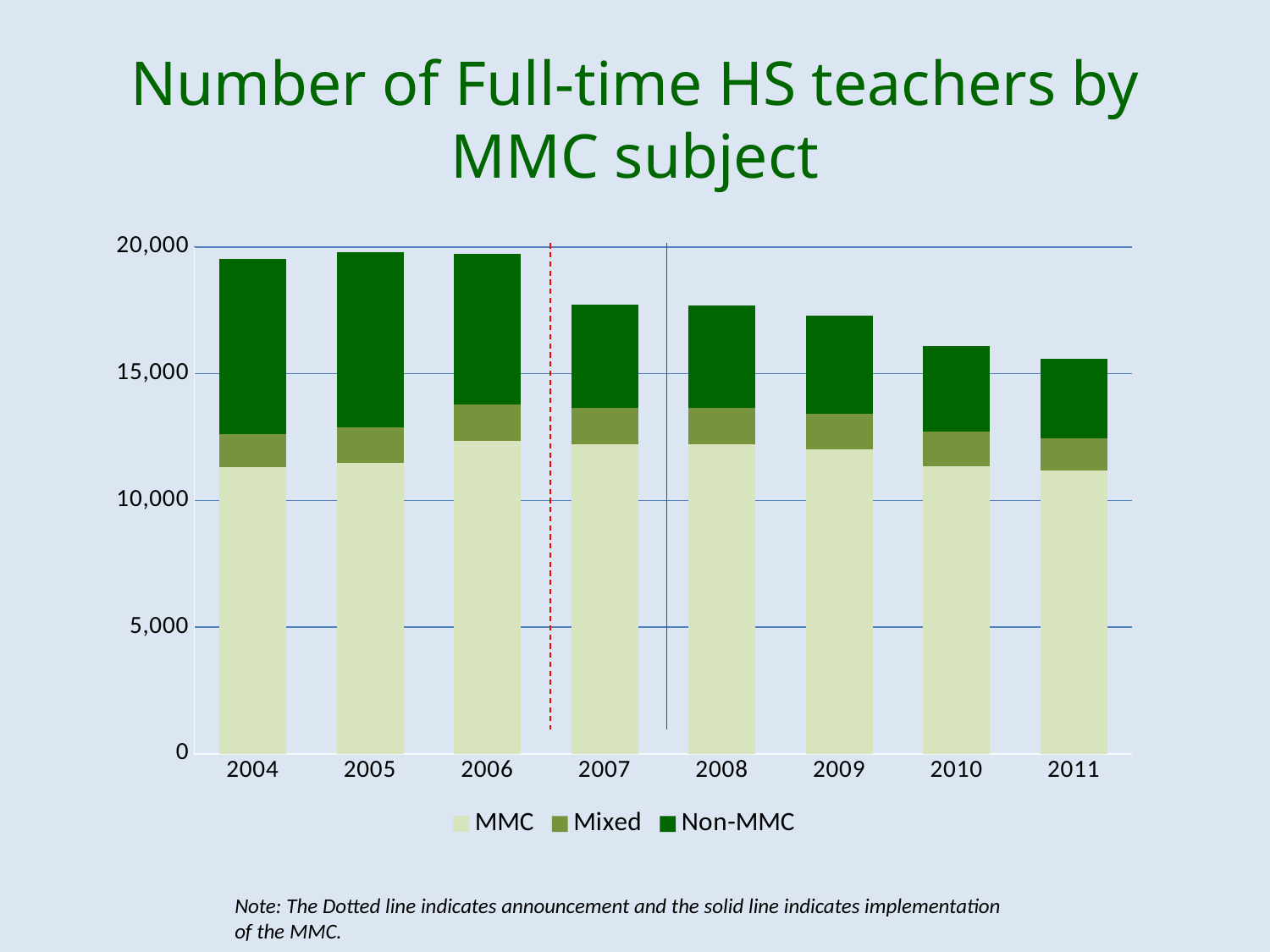
Is the total number of full-time HS teachers in 2004 greater or less than 15,000? greater What kind of chart is shown on the slide? Stacked bar chart Which year has the lowest total number of full-time HS teachers? 2011 Which series are listed in the chart's legend? MMC, Mixed, Non-MMC According to the note on the slide, what does the dotted line in the chart indicate? Announcement of the MMC Is the total number of full-time HS teachers in 2010 greater or less than 15,000? greater Is the total number of full-time HS teachers in 2011 greater or less than 20,000? less Which year has the larger total number of full-time HS teachers, 2004 or 2011? 2004 Do the total numbers of full-time HS teachers generally rise or fall from 2004 to 2011? Fall How many series does the chart's legend list? 3 How many years are shown along the x axis of the chart? 8